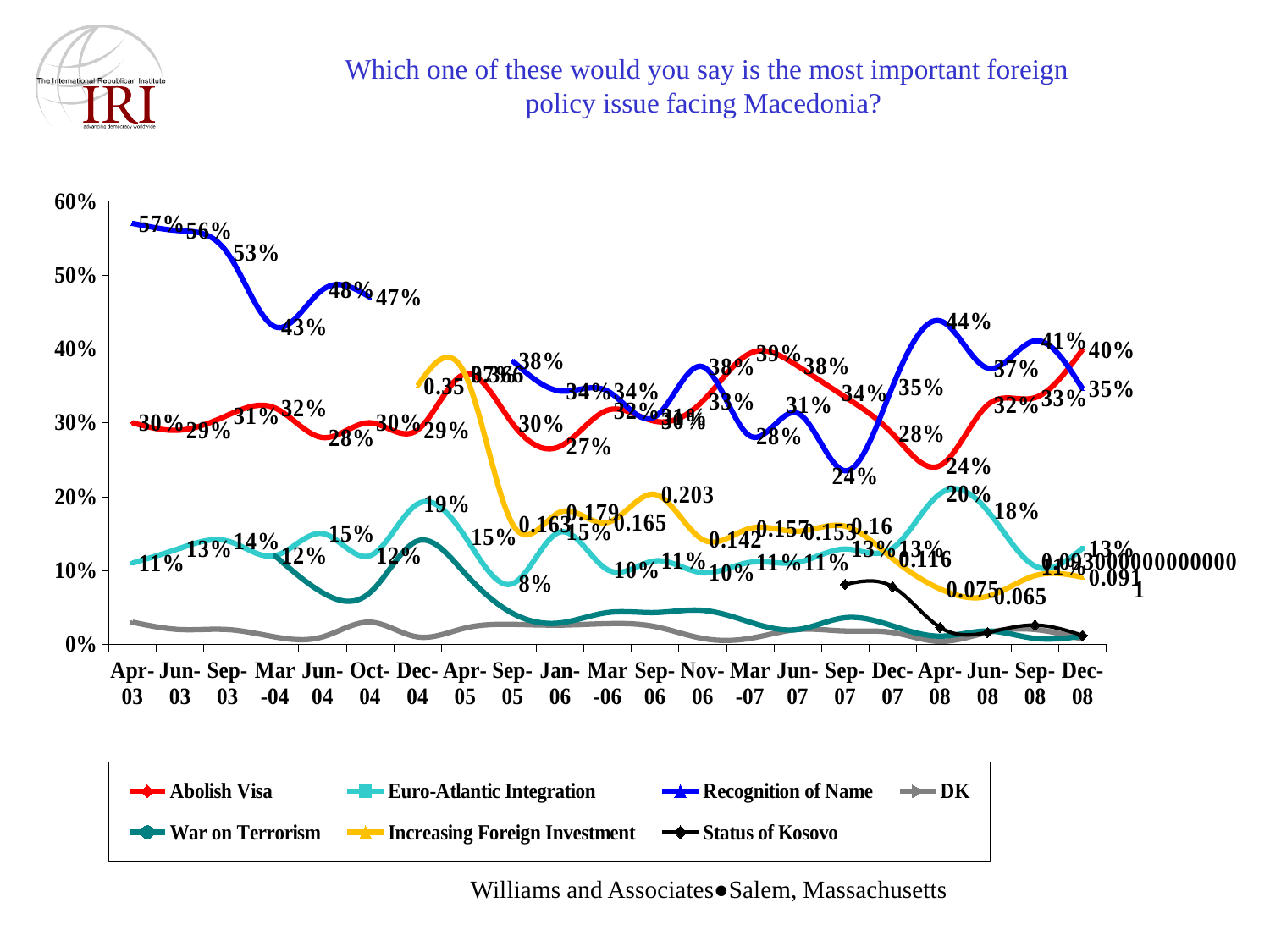
What kind of chart is shown on the slide? line chart How many series does the legend list? 7 What is the value for Recognition of Name in Apr-08? 44% Does the Recognition of Name line rise or fall from Apr-03 to Mar-04? fall In Dec-08, which is larger: Abolish Visa or Recognition of Name? Abolish Visa What is the value for Recognition of Name in Apr-03? 57% What is the value for Increasing Foreign Investment in Apr-08? 0.075 In which period does Recognition of Name reach its highest value? Apr-03 What is the value for Abolish Visa in Dec-08? 40% Is the value for DK in Apr-03 greater or less than 10%? less What is the difference in percentage points between Recognition of Name in Apr-03 and in Mar-04? 14 What is the value for Euro-Atlantic Integration in Dec-04? 19%